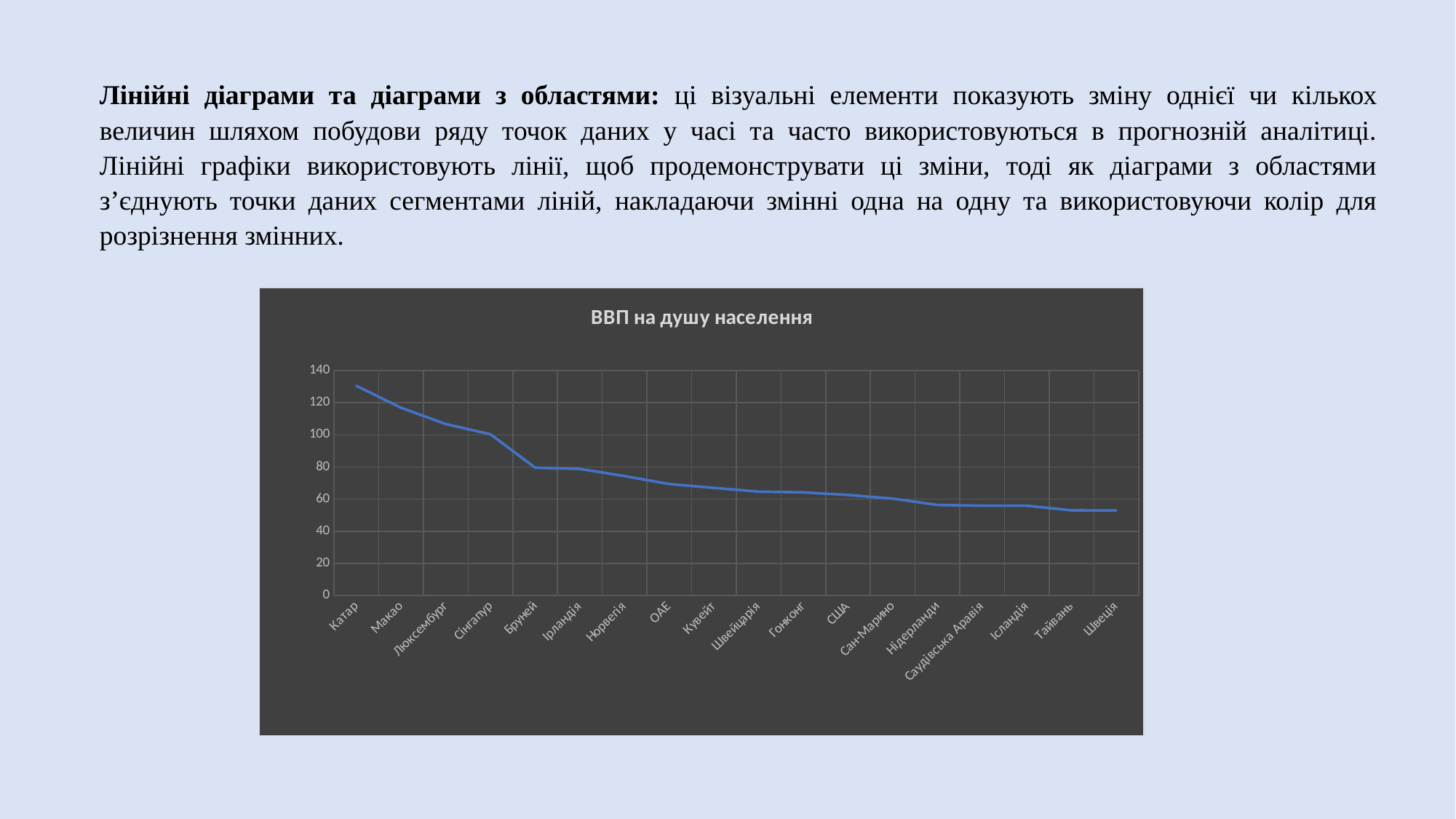
Is the value for Бруней greater or less than 100? less Is the value for Катар greater or less than 120? greater Is the value for Макао greater or less than 100? greater Which country is plotted first on the x axis? Катар Which has the larger value, Люксембург or Бруней? Люксембург How many countries are plotted on the x axis of the chart? 18 Which country has the highest value in the chart? Катар What is the title of the chart? ВВП на душу населення What kind of chart is shown on the slide? line chart Do the values rise or fall moving from left to right along the x axis? fall